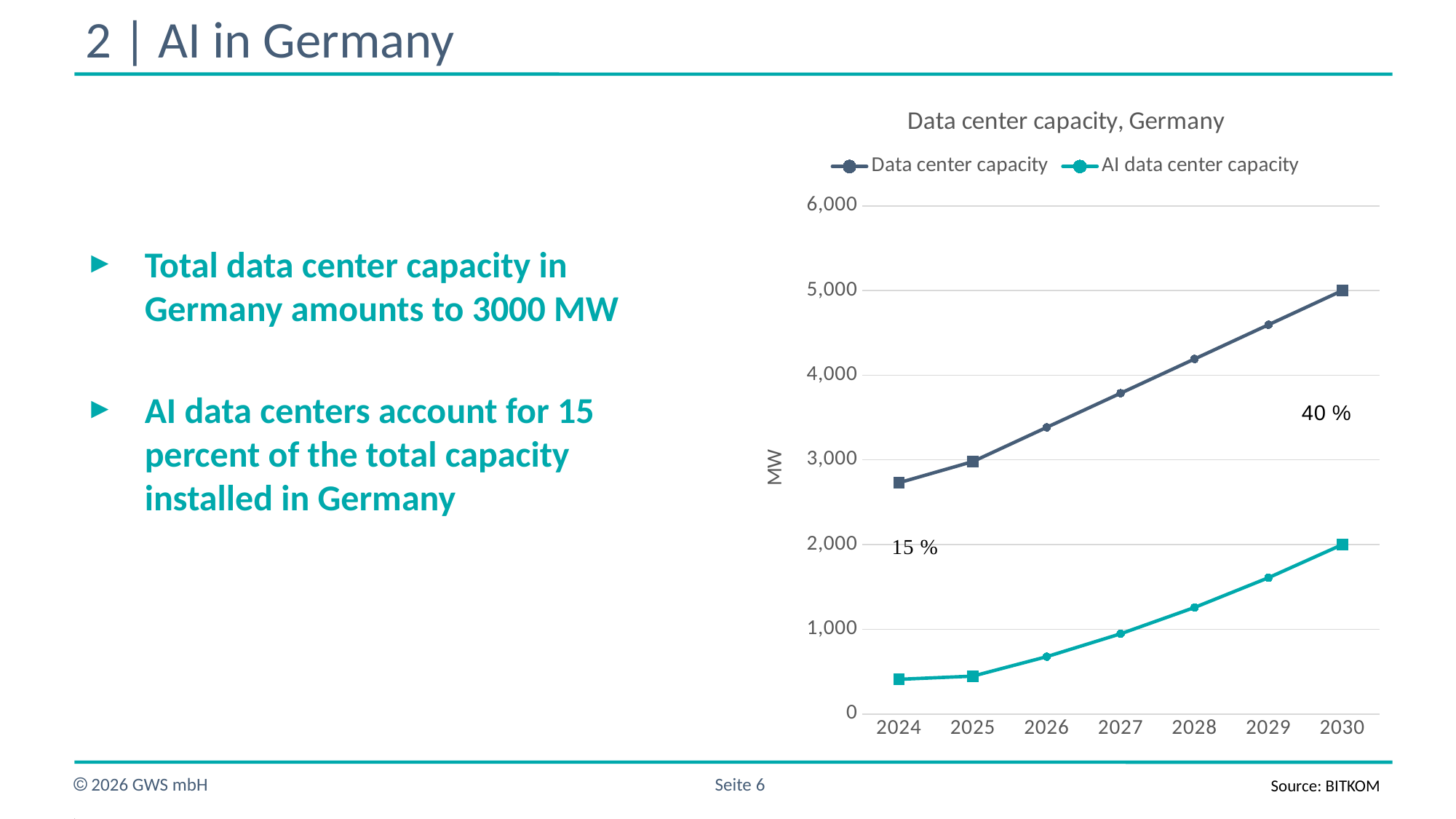
Which series has the higher value in 2030, Data center capacity or AI data center capacity? Data center capacity What is the Data center capacity value for 2030? 5,000 What is the title of the chart? Data center capacity, Germany How many series does the chart legend list? 2 What kind of chart is shown on the slide? line chart What is the AI data center capacity value for 2030? 2,000 Is the Data center capacity value for 2024 greater or less than 3,000? less Is the Data center capacity value for 2028 greater or less than 4,000? greater How many years are shown on the x axis of the chart? 7 Does the AI data center capacity series rise or fall from 2024 to 2030? rise